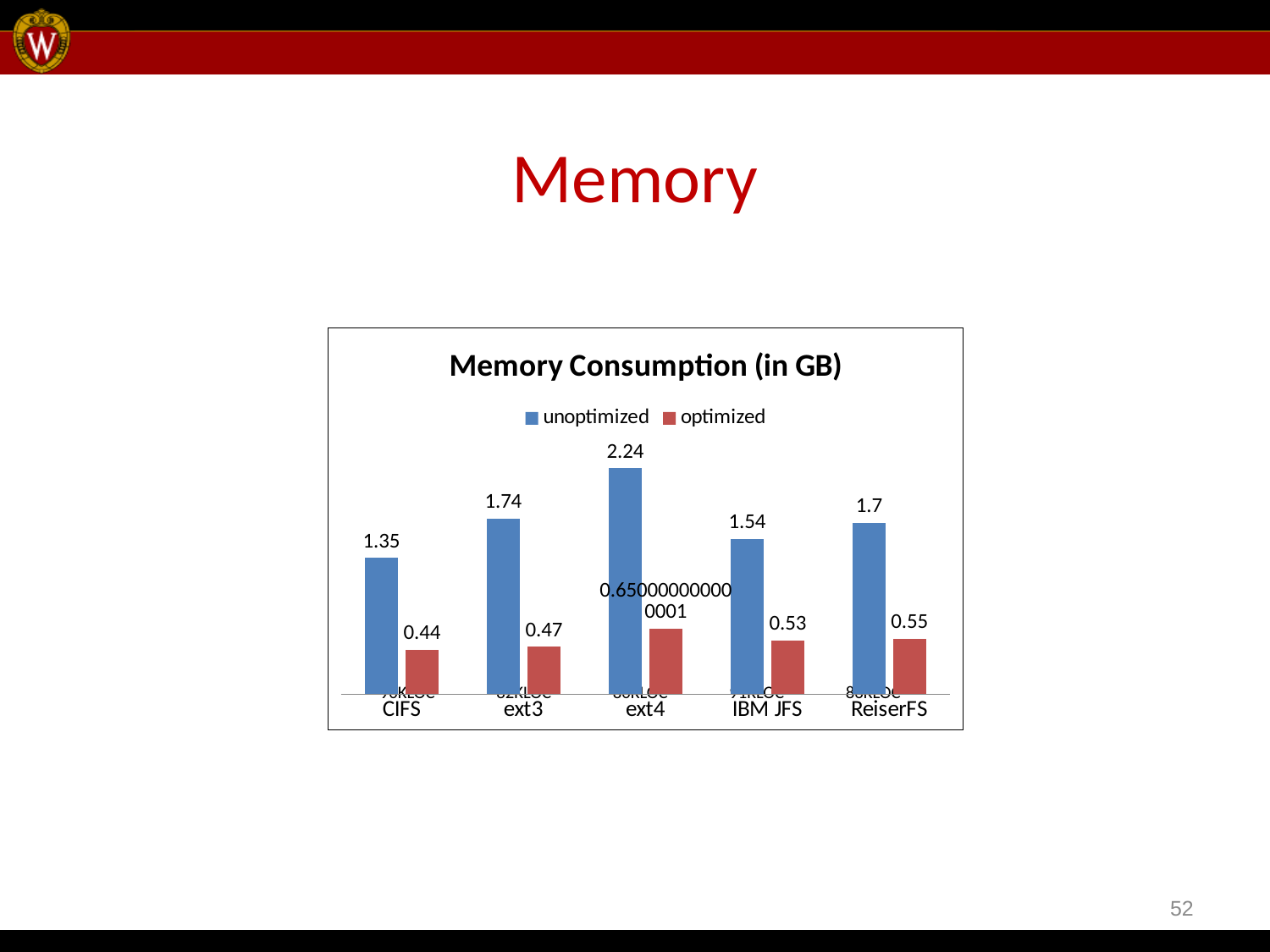
What kind of chart is shown on the slide? bar chart What is the optimized memory consumption for IBM JFS? 0.53 What is the unoptimized memory consumption for ReiserFS? 1.7 What is the difference between the unoptimized and optimized memory consumption for ext3? 1.27 What is the difference between the unoptimized and optimized memory consumption for CIFS? 0.91 What is the unoptimized memory consumption for ext4? 2.24 What is the optimized memory consumption for CIFS? 0.44 How many series does the legend list? 2 Which file system has the lowest optimized memory consumption? CIFS Which file system has the highest unoptimized memory consumption? ext4 How many file systems are shown on the x axis? 5 Which is larger, the unoptimized memory consumption for ext3 or for IBM JFS? ext3